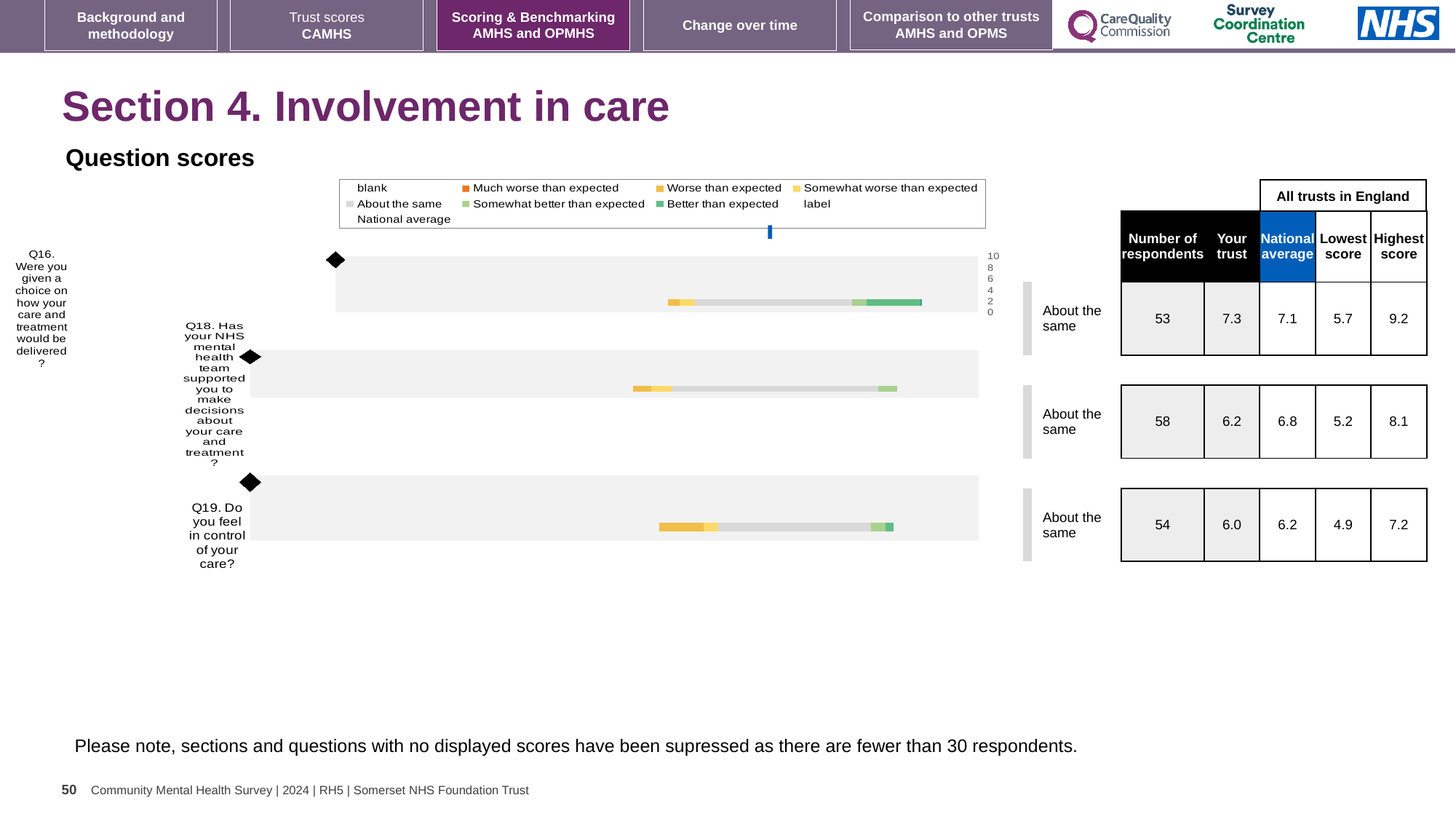
What is the National average score for Q18 (Has your NHS mental health team supported you to make decisions about your care and treatment?)? 6.8 What kind of chart is used to show the question scores for Q16, Q18 and Q19? bar chart Which question has the lowest 'Your trust' score? Q19 What benchmark category label is shown next to each of the three question charts? About the same What is the 'Your trust' score for Q16 (Were you given a choice on how your care and treatment would be delivered?)? 7.3 What is the difference between the Highest score and the Lowest score for Q16? 3.5 How many questions are plotted in the Question scores charts? 3 For Q18, which is larger: the 'Your trust' score or the National average? National average Which question has the highest 'Your trust' score? Q16 What heading appears above the Lowest score and Highest score columns in the table? All trusts in England How many respondents are shown for Q19 (Do you feel in control of your care?)? 54 What is the difference between the National average and the 'Your trust' score for Q19? 0.2